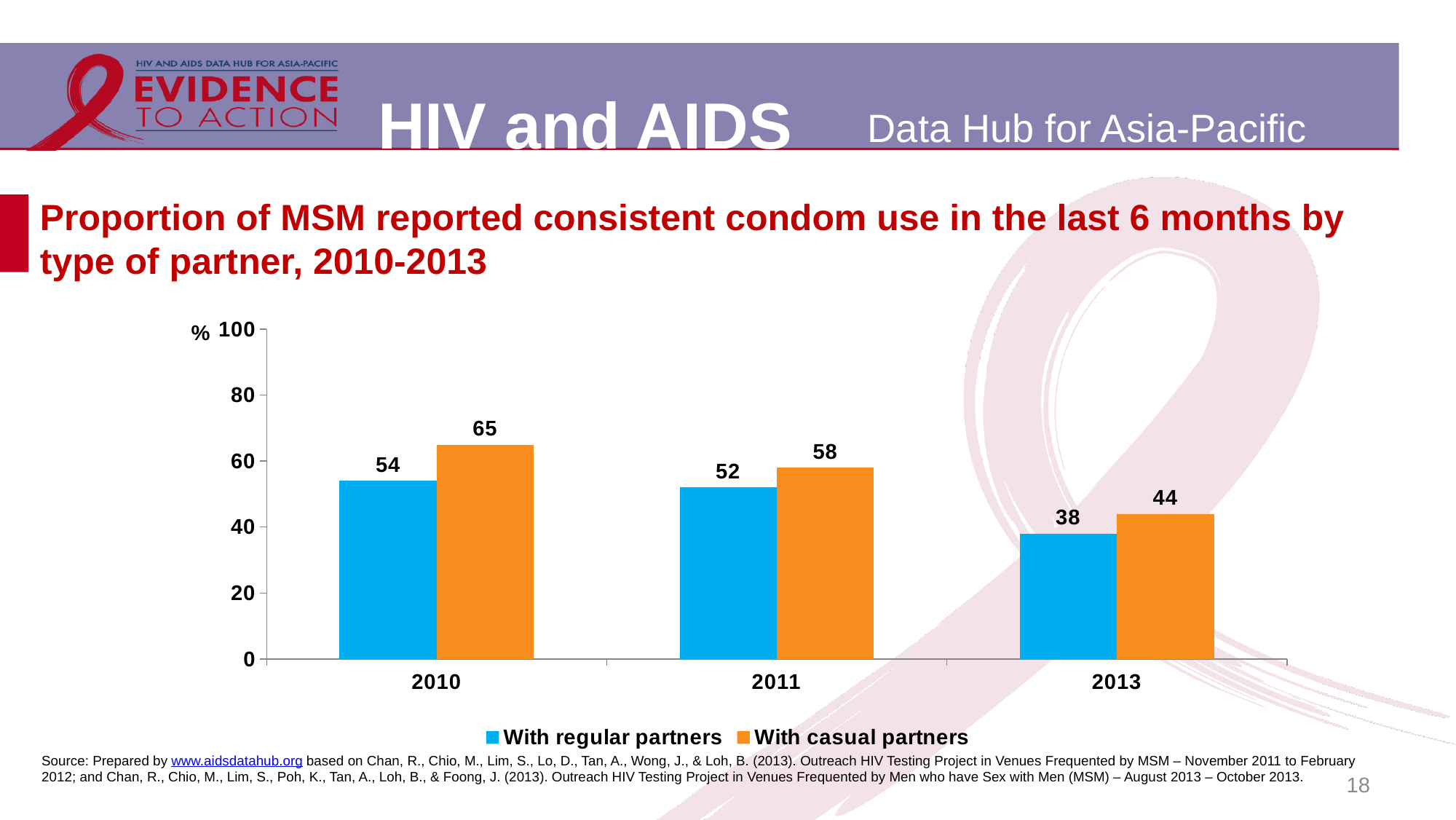
In which year is the value for 'With casual partners' highest? 2010 What kind of chart is shown on the slide? Bar chart In which year is the value for 'With regular partners' lowest? 2013 How many series does the legend list? 2 What is the difference between 'With casual partners' and 'With regular partners' in 2010? 11 How many years are shown on the x axis? 3 Is the value for 'With regular partners' in 2013 greater or less than 40? less What is the value for 'With regular partners' in 2010? 54 Do the values for 'With regular partners' rise or fall from 2010 to 2013? Fall What is the value for 'With casual partners' in 2013? 44 What is the value for 'With casual partners' in 2011? 58 Which is larger in 2011: 'With regular partners' or 'With casual partners'? With casual partners